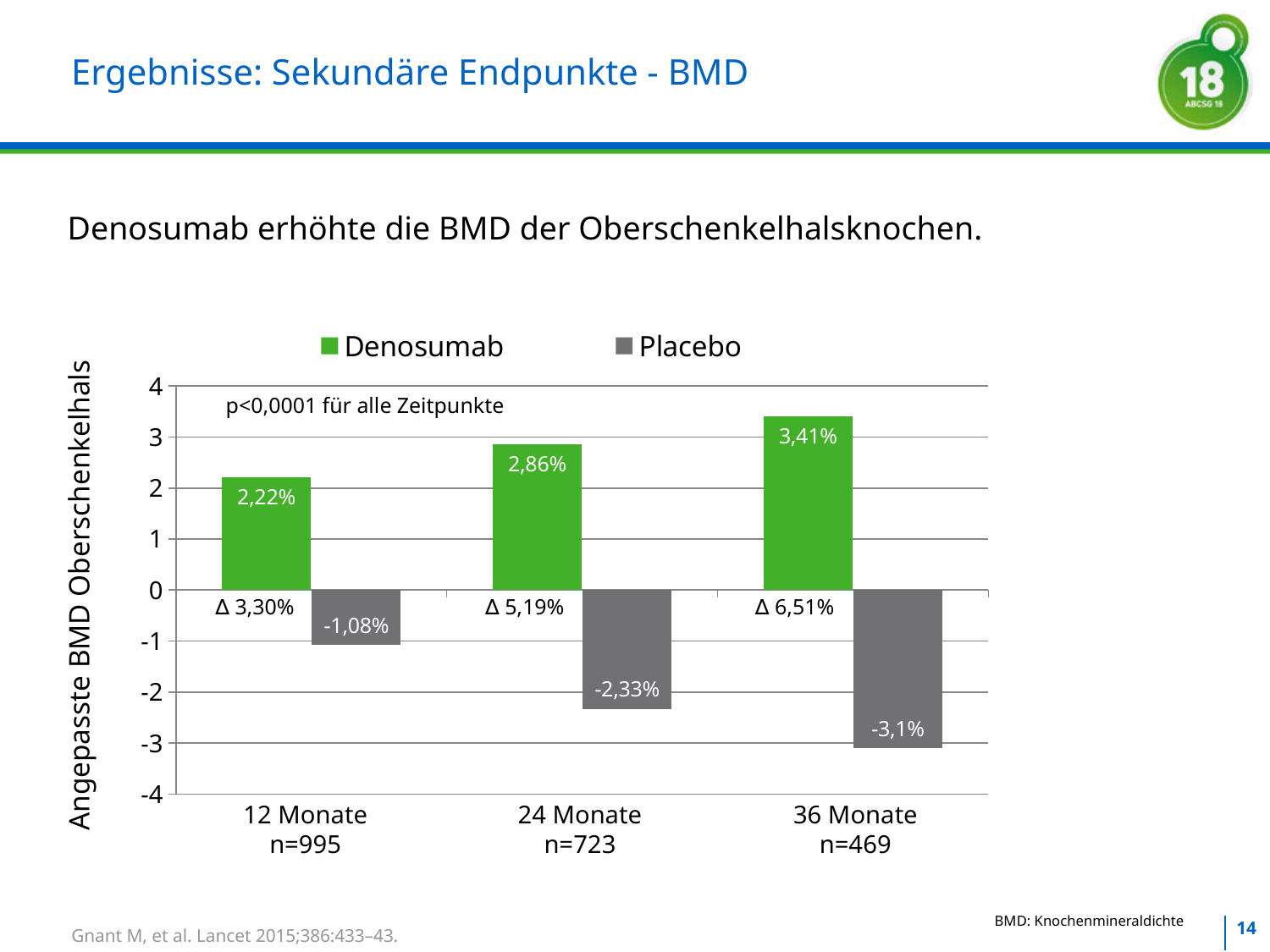
Do the Denosumab values rise or fall from 12 Monate to 36 Monate? rise How many series does the legend list? 2 Is the Denosumab value at 36 Monate greater or less than 3? greater What is the Denosumab value at 12 Monate? 2,22% What is the difference between the Denosumab and Placebo values at 12 Monate? 3,30% At which time point is the Placebo value lowest? 36 Monate Which is larger, the Denosumab value at 24 Monate or at 36 Monate? 36 Monate How many time points are shown on the x axis? 3 What kind of chart is shown? bar chart What is the Placebo value at 36 Monate? -3,1% At which time point is the Denosumab value highest? 36 Monate What is the Placebo value at 24 Monate? -2,33%